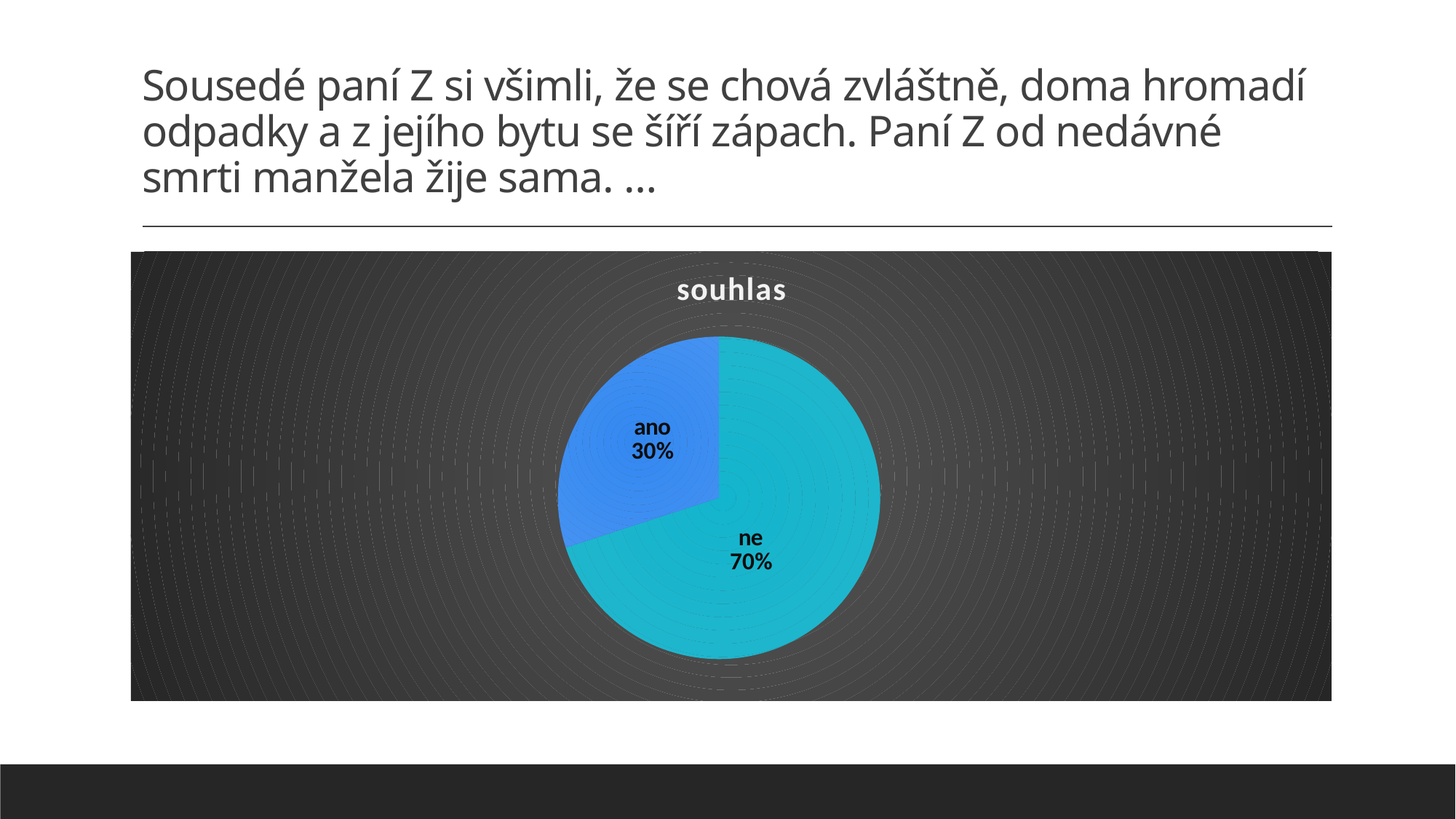
How many slices does the pie chart have? 2 Which slice is the largest in the pie chart? ne What kind of chart is shown on the slide? pie chart Is the share for "ano" greater or less than 50%? less What colour is the "ne" slice? cyan What share of the pie does the "ano" slice represent? 30% Which is larger, the "ano" slice or the "ne" slice? ne What is the difference in percentage points between the "ne" and "ano" slices? 40 percentage points What share of the pie does the "ne" slice represent? 70% Which slice is the smallest in the pie chart? ano What is the title of the chart? souhlas